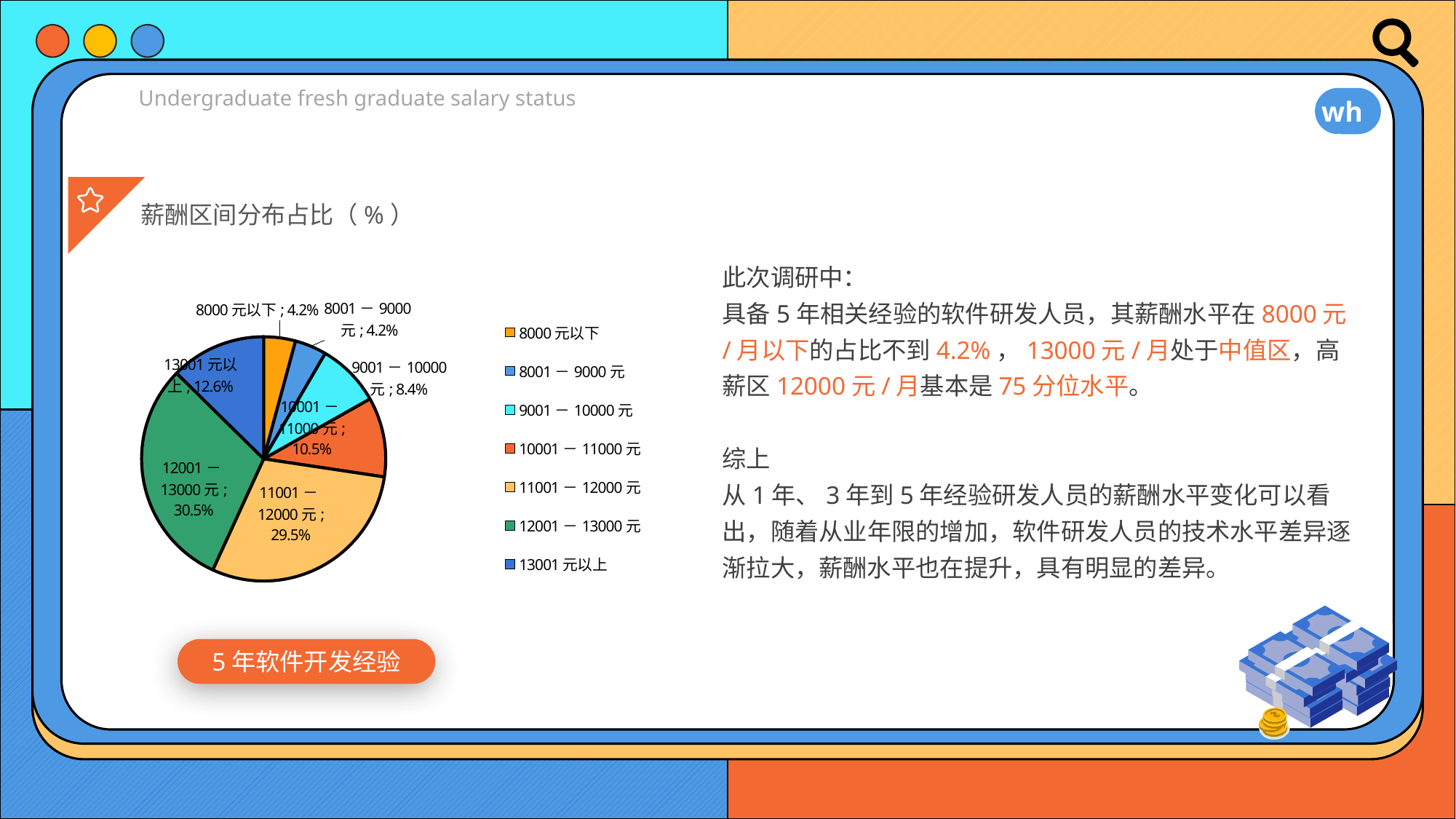
What is the title of the chart? 薪酬区间分布占比（%） What colour is the 12001－13000 元 slice in the pie chart? green What percentage is shown for the 13001 元以上 slice? 12.6% Which salary range has the largest share of the pie? 12001－13000 元 How many categories does the pie chart have? 7 Which is larger, the share for 13001 元以上 or the share for 10001－11000 元? 13001 元以上 What is the difference between the 12001－13000 元 share and the 11001－12000 元 share? 1.0% What is the value shown for the 11001－12000 元 slice? 29.5% What is the value for the 10001－11000 元 category? 10.5% What kind of chart is shown on the slide? pie chart What share of the pie does the 12001－13000 元 slice represent? 30.5% What is the value for the 9001－10000 元 category? 8.4%